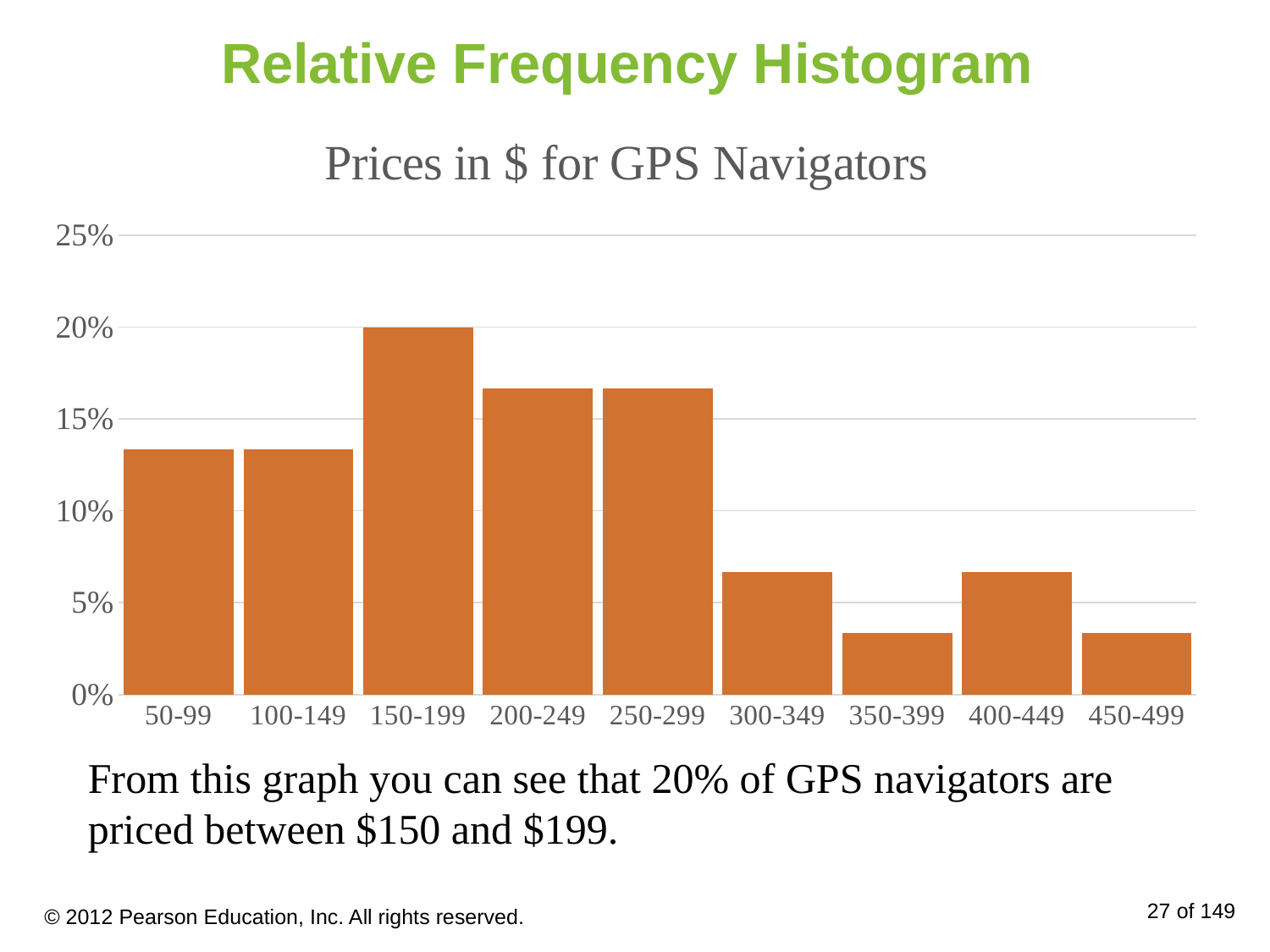
Which price class has the highest relative frequency? 150-199 Which has the larger relative frequency, the 250-299 class or the 450-499 class? 250-299 Is the value for the 300-349 price class greater or less than 10%? less Is the value for the 400-449 price class greater or less than 5%? greater What is the relative frequency for the 150-199 price class? 20% Is the value for the 200-249 price class greater or less than 15%? greater How many price classes are shown on the x axis? 9 Which has the larger relative frequency, the 150-199 class or the 300-349 class? 150-199 What kind of chart is shown on the slide? Bar chart What is the title of the chart? Prices in $ for GPS Navigators